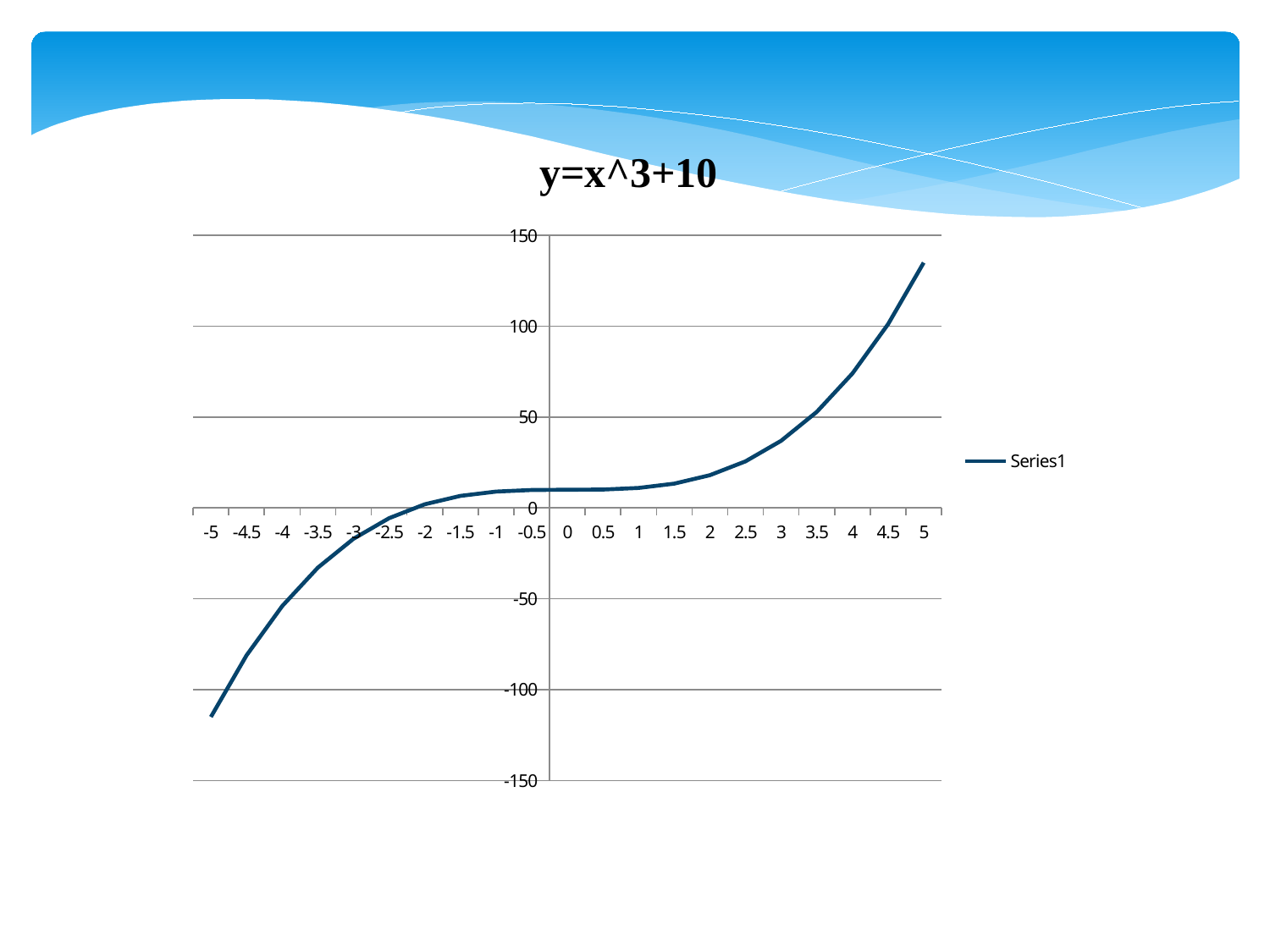
How many x-axis categories are shown on the chart? 21 Which has the larger value, x = 5 or x = -5? 5 Is the value at x = 3 greater or less than 50? less At which x value is the plotted value lowest? -5 Do the values rise or fall as x increases from -5 to 5? rise Is the value at x = 5 greater or less than 100? greater How many series does the legend list? 1 What is the title of the chart? y=x^3+10 What is the name of the series shown in the legend? Series1 At which x value is the plotted value highest? 5 What kind of chart is shown on the slide? line chart Is the value at x = -5 greater or less than -100? less